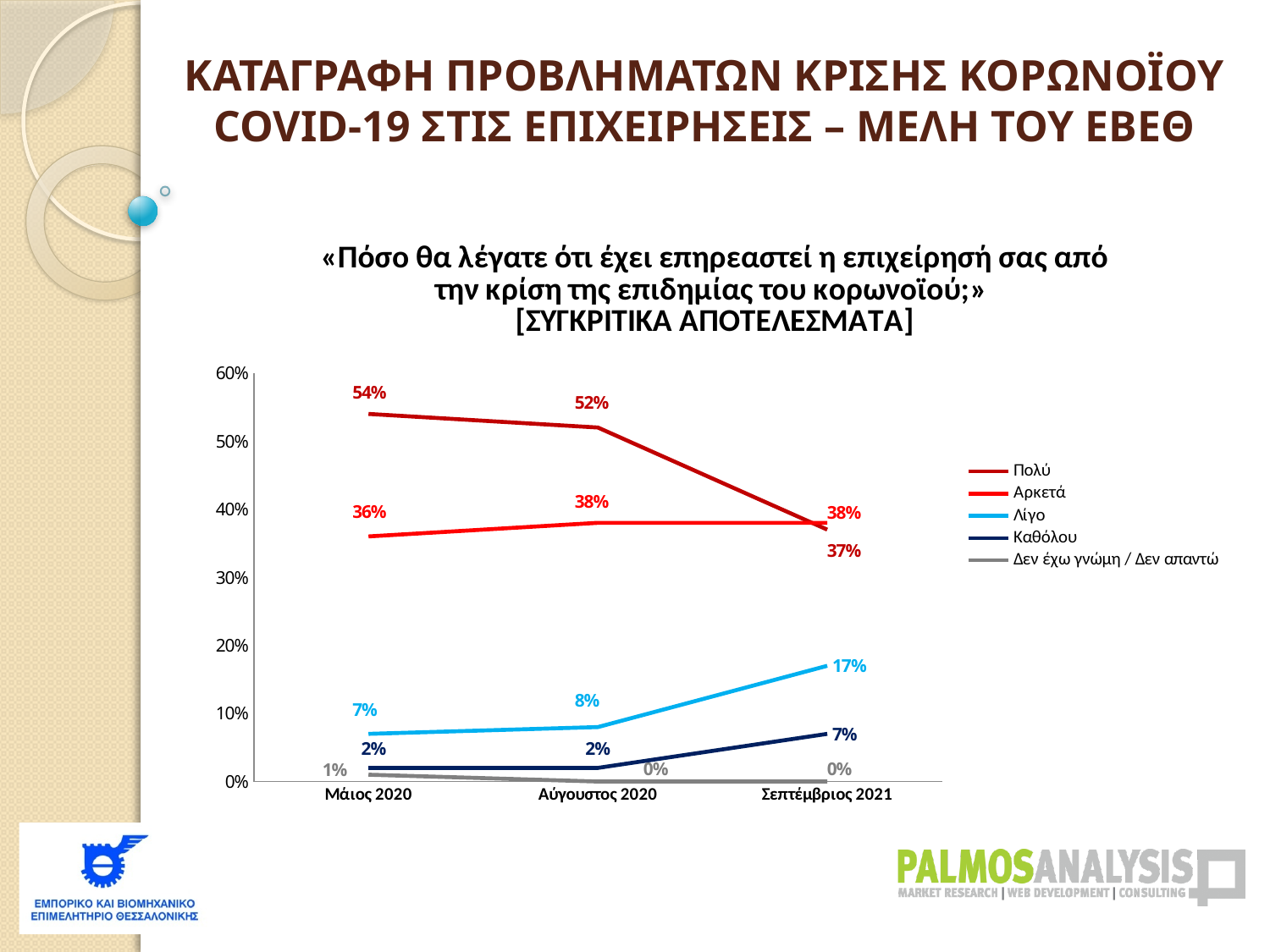
What is the value for Πολύ in Μάιος 2020? 54% What is the value for Λίγο in Σεπτέμβριος 2021? 17% In which time point is the value for Πολύ the lowest? Σεπτέμβριος 2021 What is the difference between the Πολύ values in Μάιος 2020 and Σεπτέμβριος 2021? 17% Does the value for Λίγο rise or fall from Μάιος 2020 to Σεπτέμβριος 2021? rise What type of chart is shown on the slide? line chart Which series is drawn in gray? Δεν έχω γνώμη / Δεν απαντώ What is the value for Καθόλου in Σεπτέμβριος 2021? 7% How many series does the legend list? 5 Which is larger in Αύγουστος 2020: the value for Πολύ or the value for Αρκετά? Πολύ How many time points are shown on the x axis? 3 What is the value for Αρκετά in Αύγουστος 2020? 38%